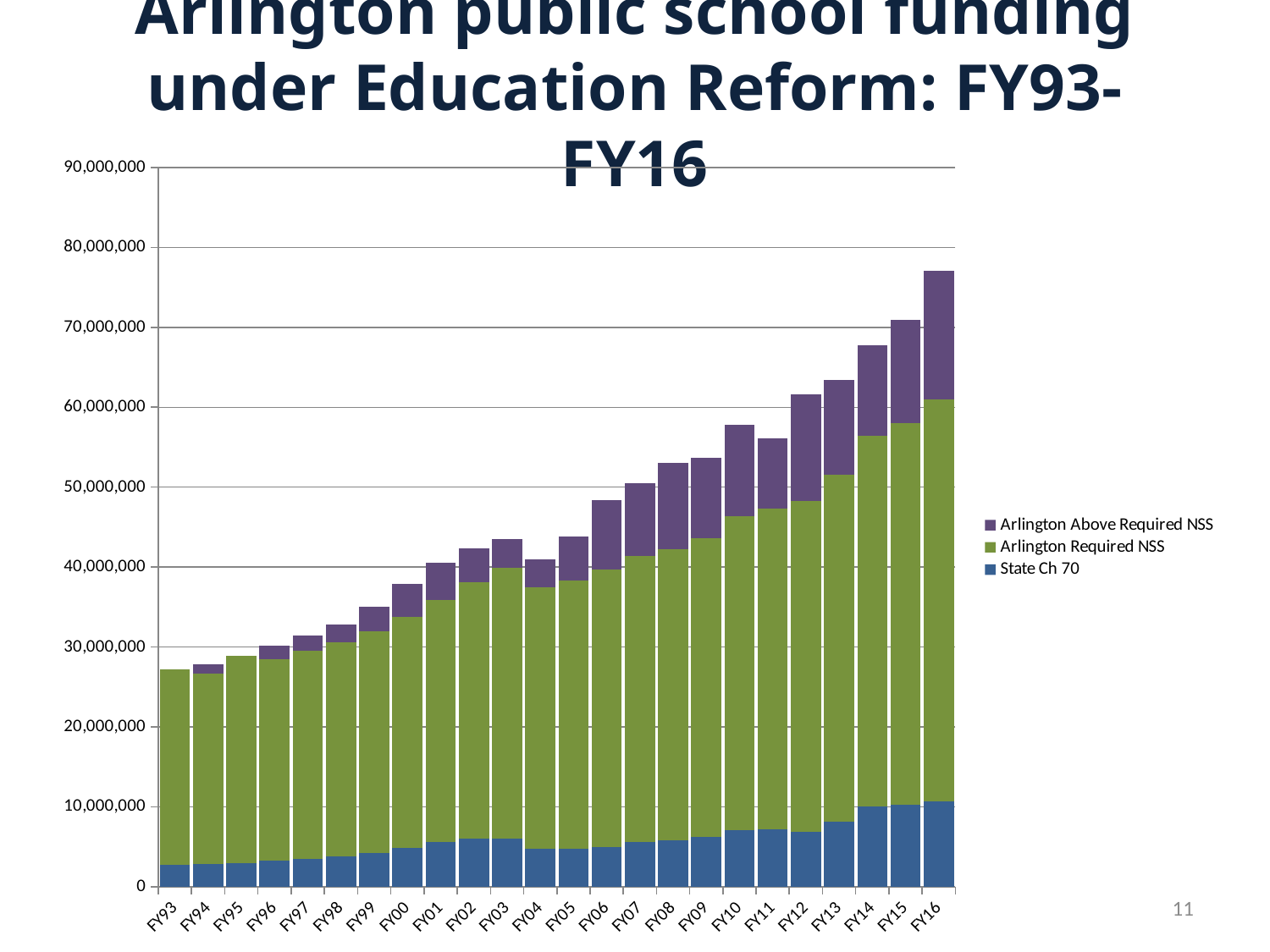
Is the total funding for FY16 greater or less than 70,000,000? greater Is the total funding for FY14 greater or less than 70,000,000? less How many series does the legend list? 3 Is the total funding for FY93 greater or less than 30,000,000? less What kind of chart is shown on the slide? Stacked bar chart Which has the larger total funding, FY10 or FY11? FY10 Do the total funding values generally rise or fall from FY93 to FY16? rise How many fiscal years (categories) are plotted on the x axis? 24 Which fiscal year has the highest total funding? FY16 Which fiscal year has the lowest total funding? FY93 Which series is shown at the bottom of each stacked bar? State Ch 70